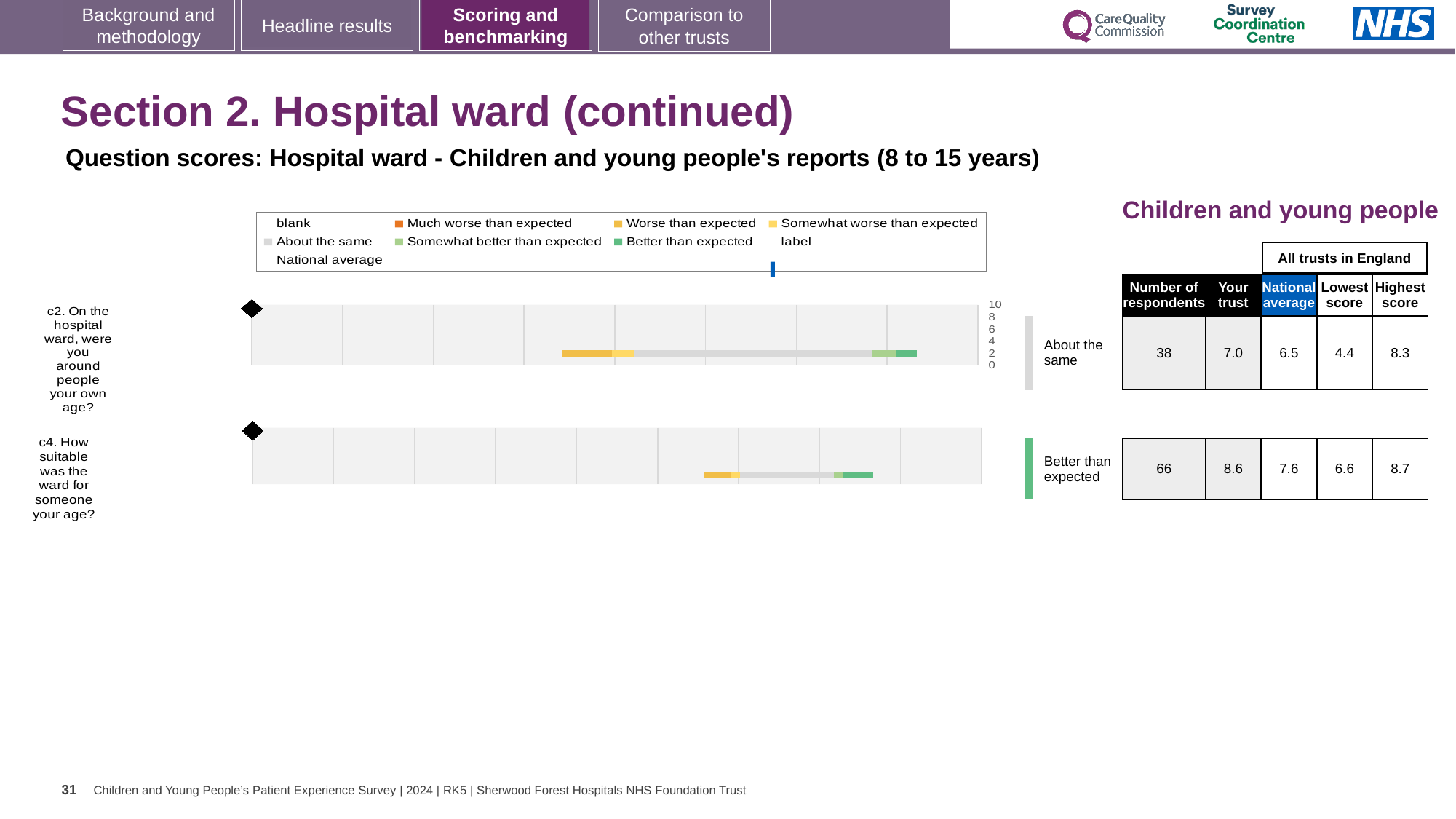
What is the national average score for question c2? 6.5 Which question has the higher 'Your trust' score, c2 or c4? c4 What is the 'Your trust' score for question c2 (On the hospital ward, were you around people your own age?)? 7.0 What is the 'Your trust' score for question c4 (How suitable was the ward for someone your age?)? 8.6 What is the difference between the trust score and the national average for question c2? 0.5 What kind of chart is used to show the question scores on this slide? bar chart What is the lowest score across all trusts in England for question c2? 4.4 What is the highest score across all trusts in England for question c4? 8.7 How many respondents answered question c4? 66 What is the difference between the trust score and the national average for question c4? 1.0 How many questions are plotted in the chart on this slide? 2 Which benchmark category is question c2 placed in? About the same